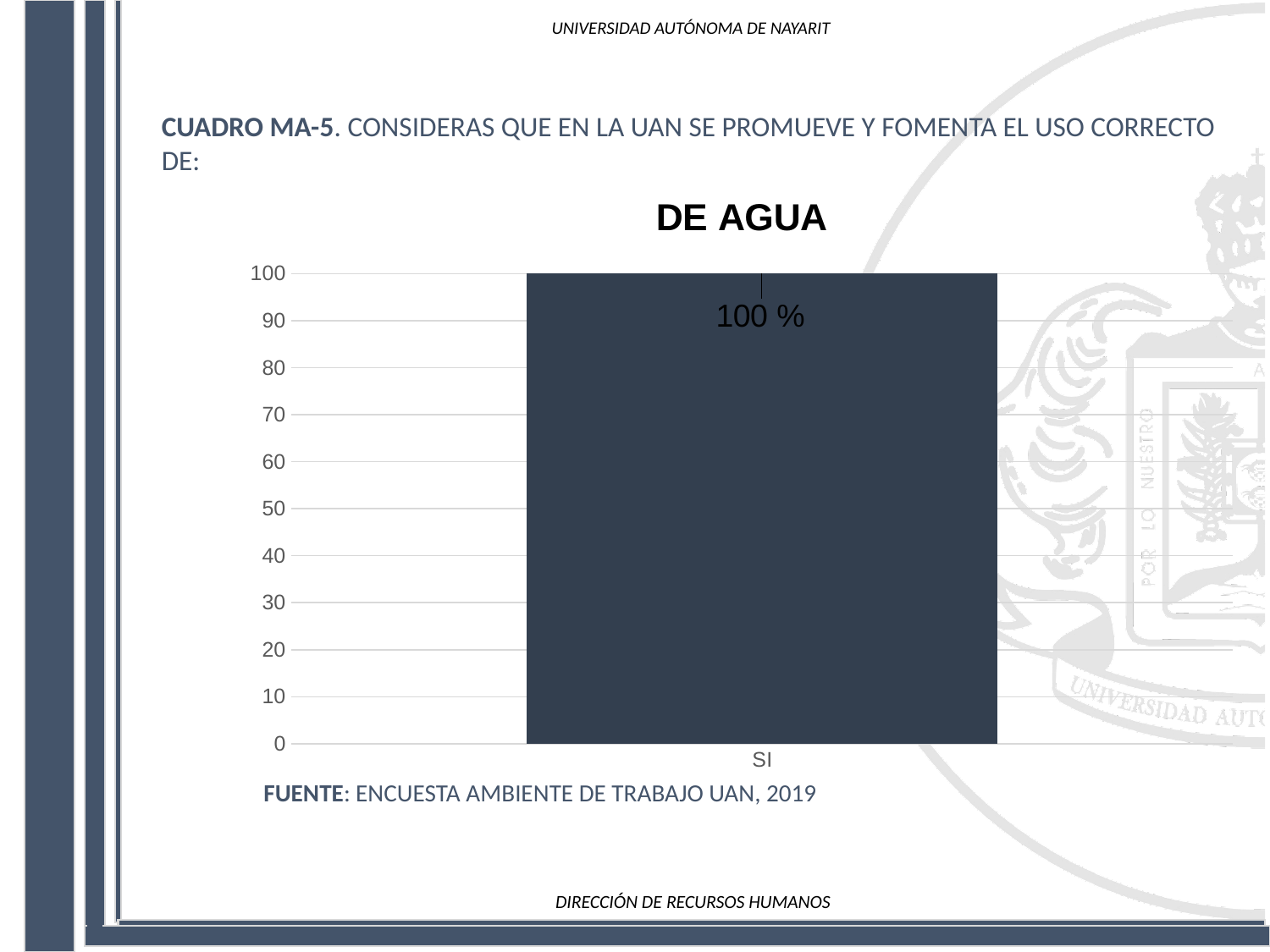
How many categories are shown on the x axis of the chart? 1 What is the highest value shown on the y axis? 100 Which category has the highest value in the chart? SI What is the title of the chart? DE AGUA What is the value for SI in the DE AGUA chart? 100 % What kind of chart is shown on the slide? bar chart What is the label of the only category on the x axis? SI Is the value for SI greater or less than 50? greater